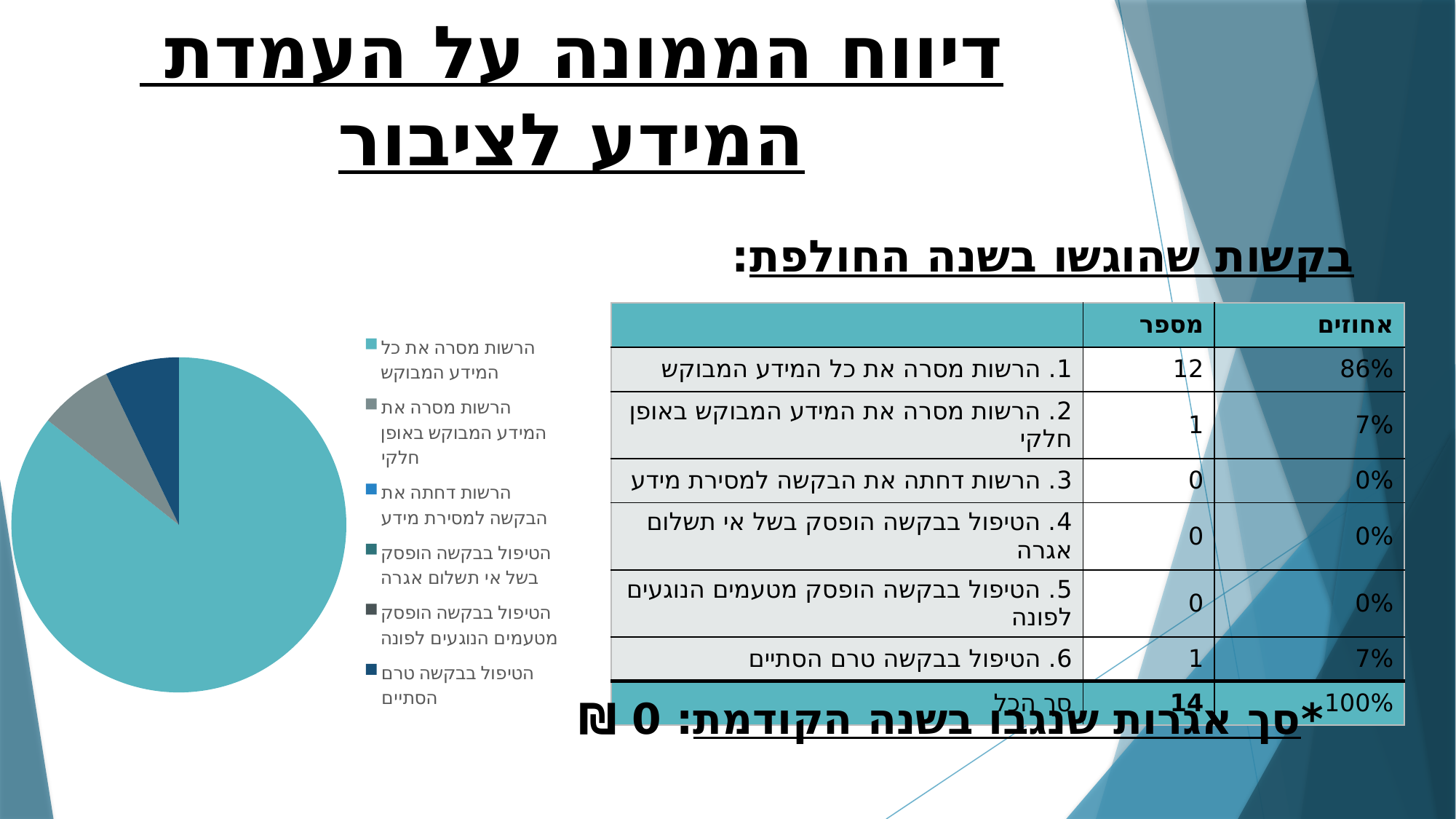
According to the slide, what share of the pie does הרשות מסרה את כל המידע המבוקש represent? 86% What colour is the largest slice of the pie chart? teal How many slices are visibly drawn in the pie chart? 3 Which legend entry is listed first in the pie chart's legend? הרשות מסרה את כל המידע המבוקש What kind of chart is shown on the left of the slide? pie chart Which slice is larger in the pie chart: הרשות מסרה את כל המידע המבוקש or הרשות מסרה את המידע המבוקש באופן חלקי? הרשות מסרה את כל המידע המבוקש Does the slice for הרשות מסרה את כל המידע המבוקש take up more or less than half of the pie? more Which category has the largest slice in the pie chart? הרשות מסרה את כל המידע המבוקש How many entries does the legend of the pie chart list? 6 According to the slide, what share of the pie does הטיפול בבקשה טרם הסתיים represent? 7%